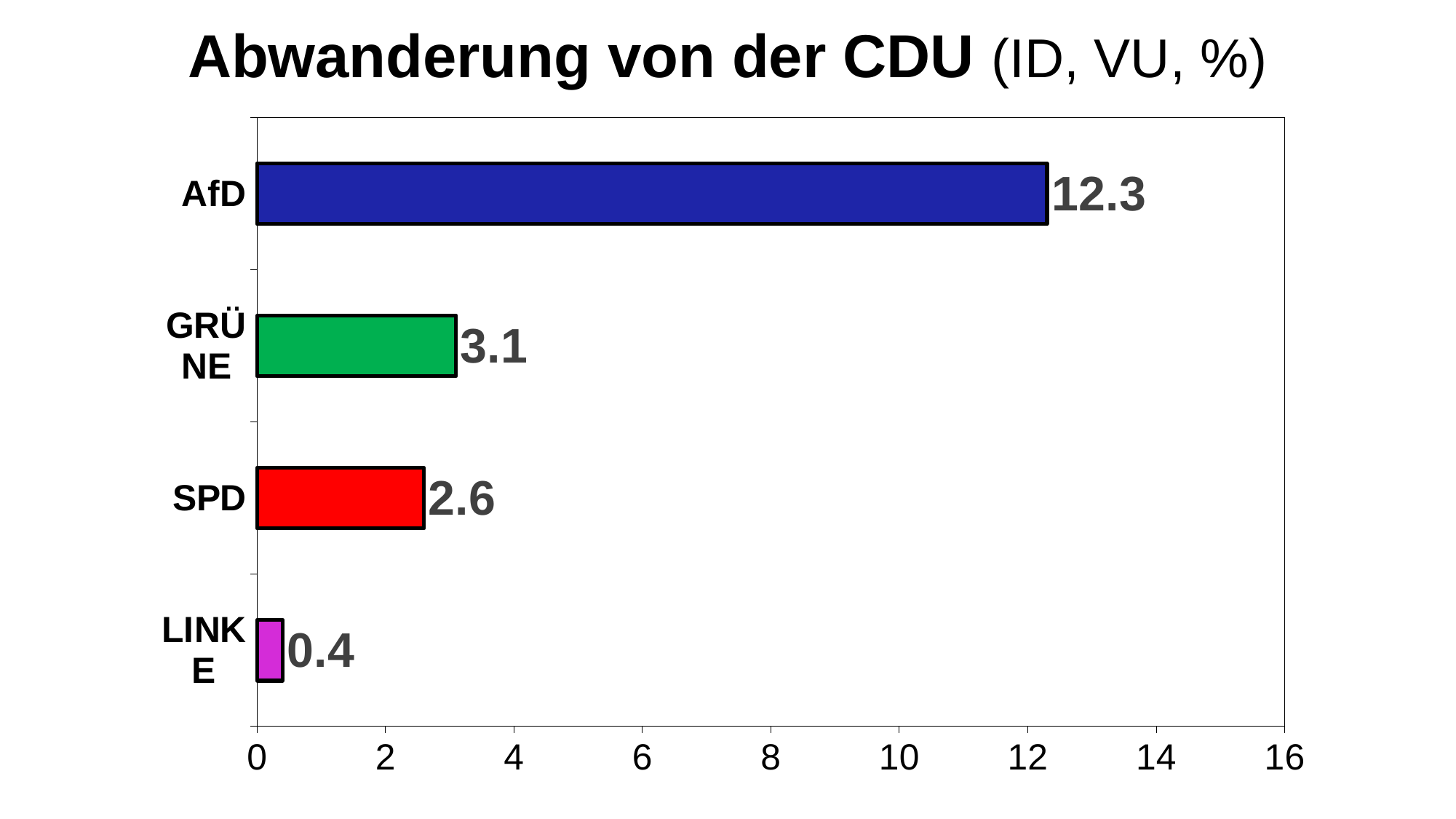
What is the difference between the values for AfD and GRÜNE? 9.2 What is the value for GRÜNE? 3.1 What is the difference between the values for SPD and LINKE? 2.2 What kind of chart is shown on the slide? Bar chart Which category has the highest value? AfD What is the title of the chart? Abwanderung von der CDU (ID, VU, %) What is the value for AfD? 12.3 Which is larger, the value for GRÜNE or the value for SPD? GRÜNE Which category has the lowest value? LINKE What is the value for SPD? 2.6 What is the value for LINKE? 0.4 How many categories are shown in the chart? 4